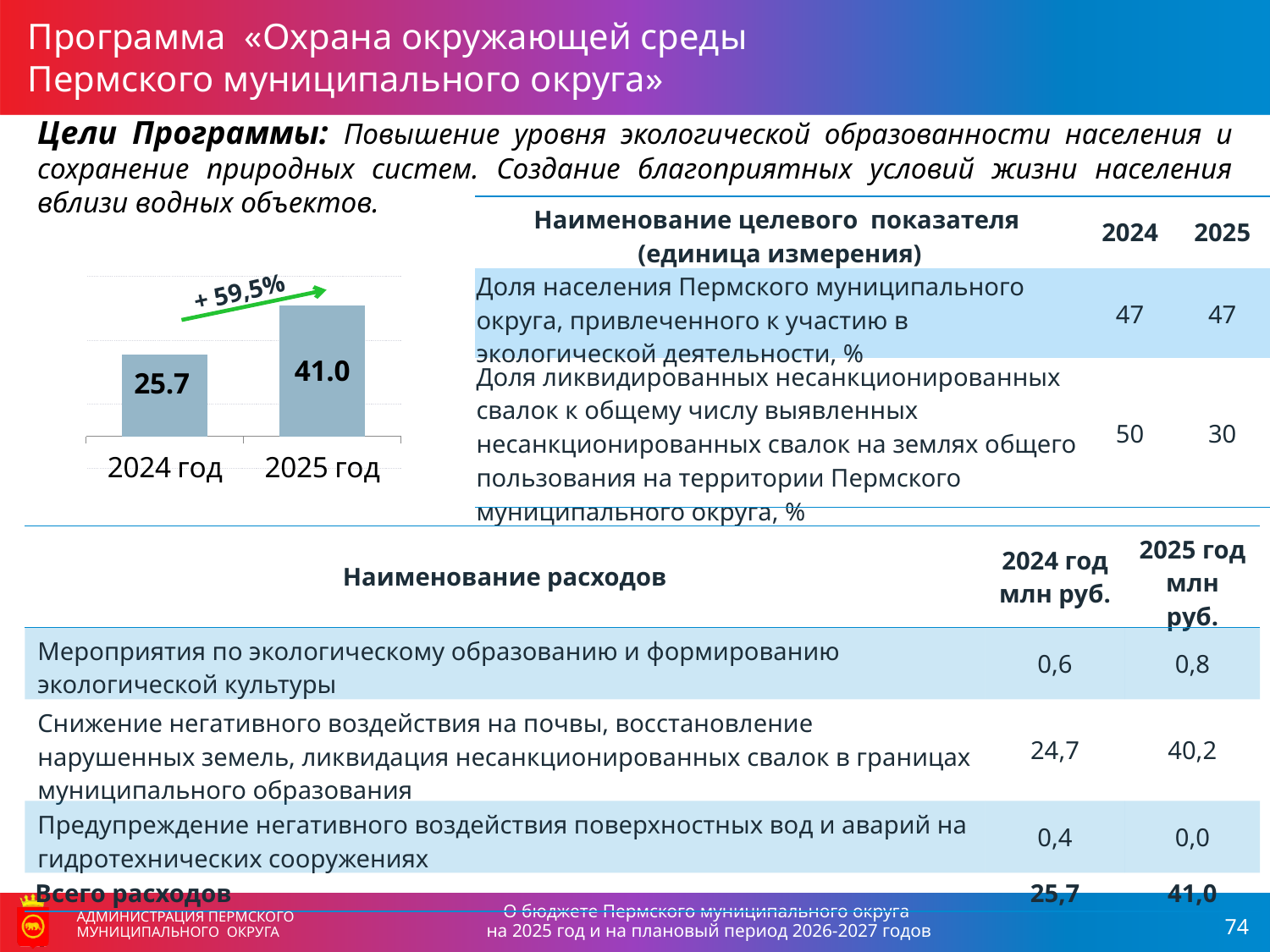
What type of chart is shown on the slide? bar chart What is the value shown for 2025 год in the bar chart? 41.0 What percentage change is annotated above the bars in the chart? + 59,5% What colour is the arrow annotation above the bars in the chart? green Is the value for 2025 год larger or smaller than the value for 2024 год? larger What is the difference between the 2025 год and 2024 год values in the bar chart? 15.3 How many bars are plotted in the chart? 2 Which year has the higher bar in the chart? 2025 год What is the value shown for 2024 год in the bar chart? 25.7 Do the values in the chart rise or fall from 2024 год to 2025 год? rise Which year has the lower bar in the chart? 2024 год